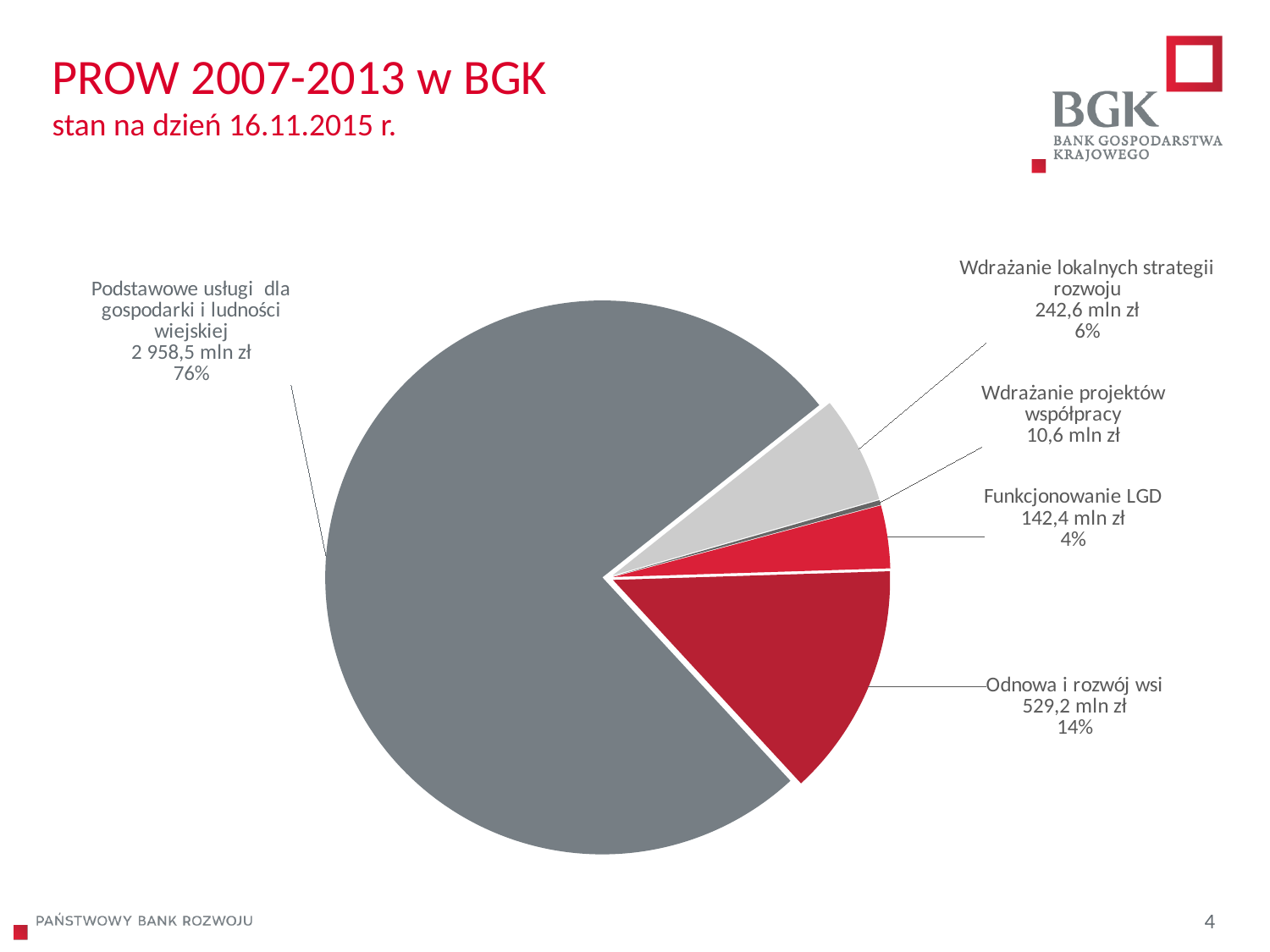
How many slices does the pie chart have? 5 Which is larger, Funkcjonowanie LGD or Wdrażanie lokalnych strategii rozwoju? Wdrażanie lokalnych strategii rozwoju Which category has the smallest slice? Wdrażanie projektów współpracy What is the value for Wdrażanie lokalnych strategii rozwoju? 242,6 mln zł What share of the pie does Podstawowe usługi dla gospodarki i ludności wiejskiej represent? 76% What share of the pie does Odnowa i rozwój wsi represent? 14% What is the difference between Odnowa i rozwój wsi and Wdrażanie lokalnych strategii rozwoju? 286,6 mln zł What kind of chart is shown on the slide? pie chart What is the value for Odnowa i rozwój wsi? 529,2 mln zł Which category has the largest slice? Podstawowe usługi dla gospodarki i ludności wiejskiej What is the value for Wdrażanie projektów współpracy? 10,6 mln zł What is the value for Funkcjonowanie LGD? 142,4 mln zł